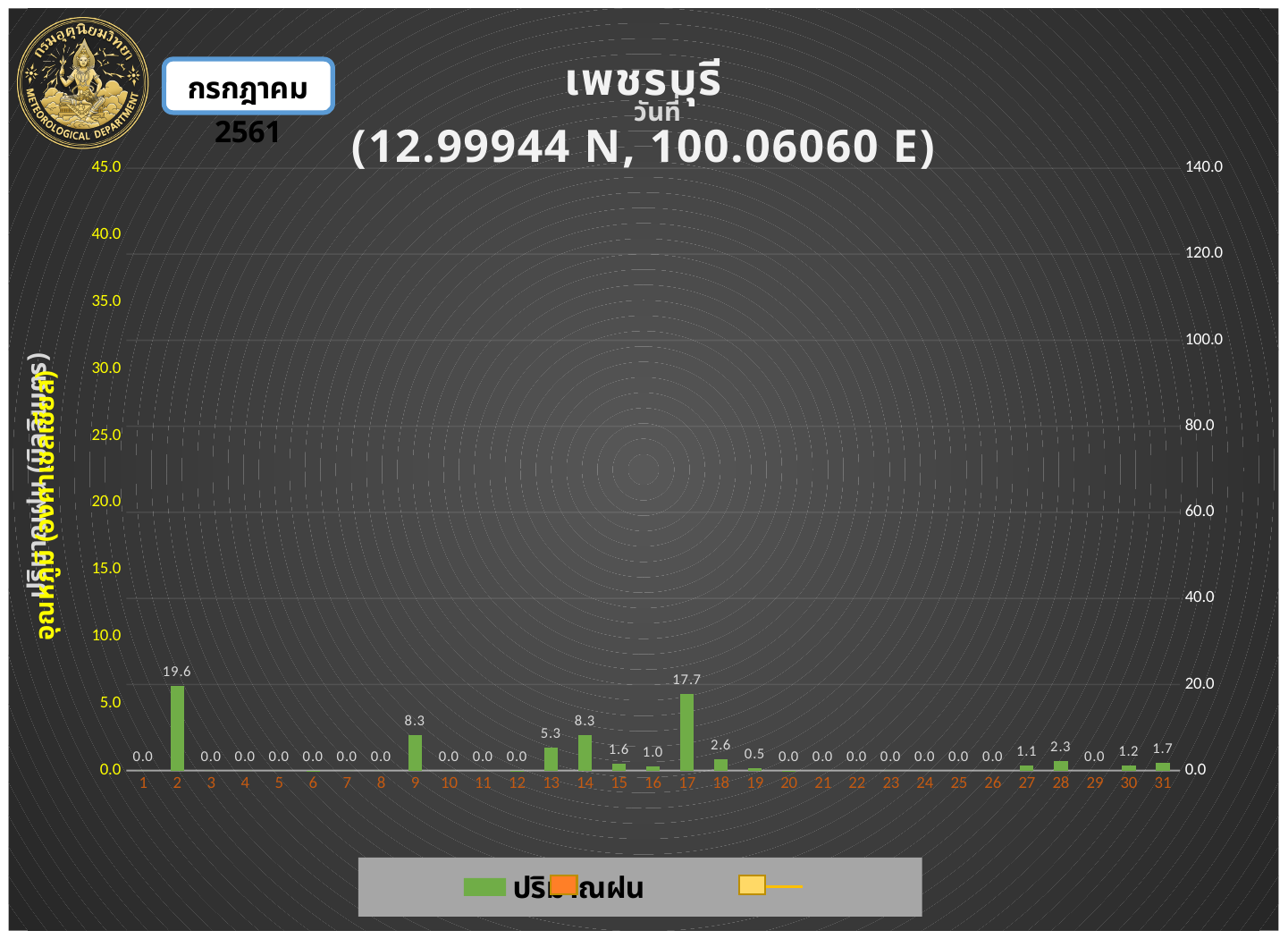
What is the difference between the rainfall values for day 2 and day 17? 1.9 What is the rainfall value shown for day 13? 5.3 What is the rainfall value shown for day 28? 2.3 Which is larger, the rainfall value for day 18 or for day 31? day 18 What is the rainfall value shown for day 2? 19.6 What is the rainfall value shown for day 17? 17.7 What is the name of the station shown in the chart title? เพชรบุรี Which is larger, the rainfall value for day 14 or for day 15? day 14 What kind of chart is used to show the rainfall data? bar chart How many days are shown on the x axis of the chart? 31 What is the difference between the rainfall values for day 9 and day 13? 3.0 Which day has the highest rainfall value? 2